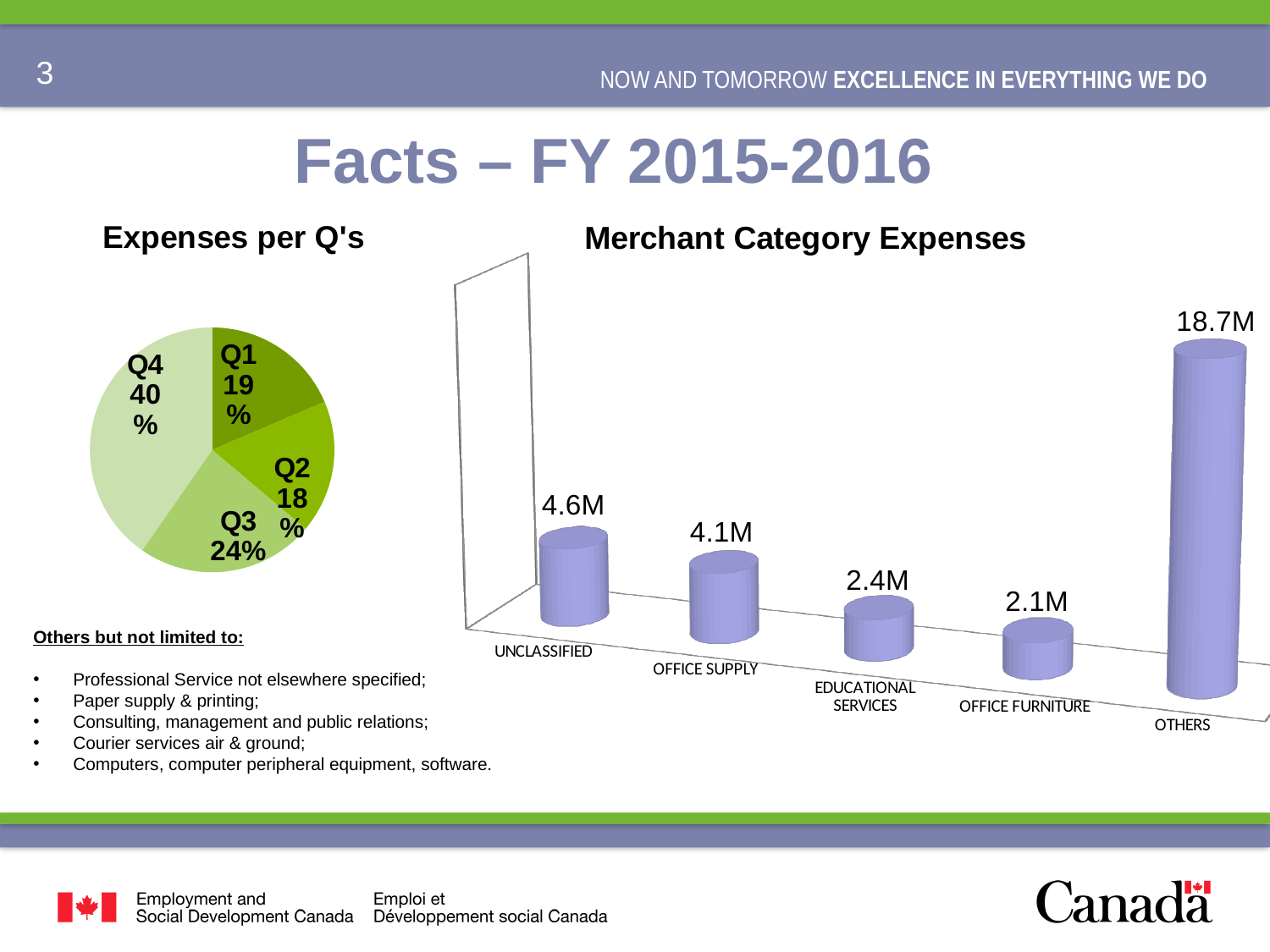
In the 'Merchant Category Expenses' chart, which category has the lowest value? OFFICE FURNITURE In the 'Merchant Category Expenses' chart, what is the value for OFFICE SUPPLY? 4.1M In the 'Merchant Category Expenses' chart, how many categories are shown? 5 In the 'Merchant Category Expenses' chart, what is the difference between UNCLASSIFIED and EDUCATIONAL SERVICES? 2.2M In the 'Merchant Category Expenses' chart, which is larger, UNCLASSIFIED or OFFICE SUPPLY? UNCLASSIFIED In the 'Merchant Category Expenses' chart, what is the value for OTHERS? 18.7M What kind of chart is 'Expenses per Q's'? Pie chart In the 'Expenses per Q's' chart, what share of expenses is Q3? 24% In the 'Expenses per Q's' chart, which quarter has the smallest share? Q2 In the 'Expenses per Q's' chart, which quarter has the largest share? Q4 In the 'Expenses per Q's' chart, what share of expenses is Q4? 40% In the 'Expenses per Q's' chart, how many slices does the pie have? 4